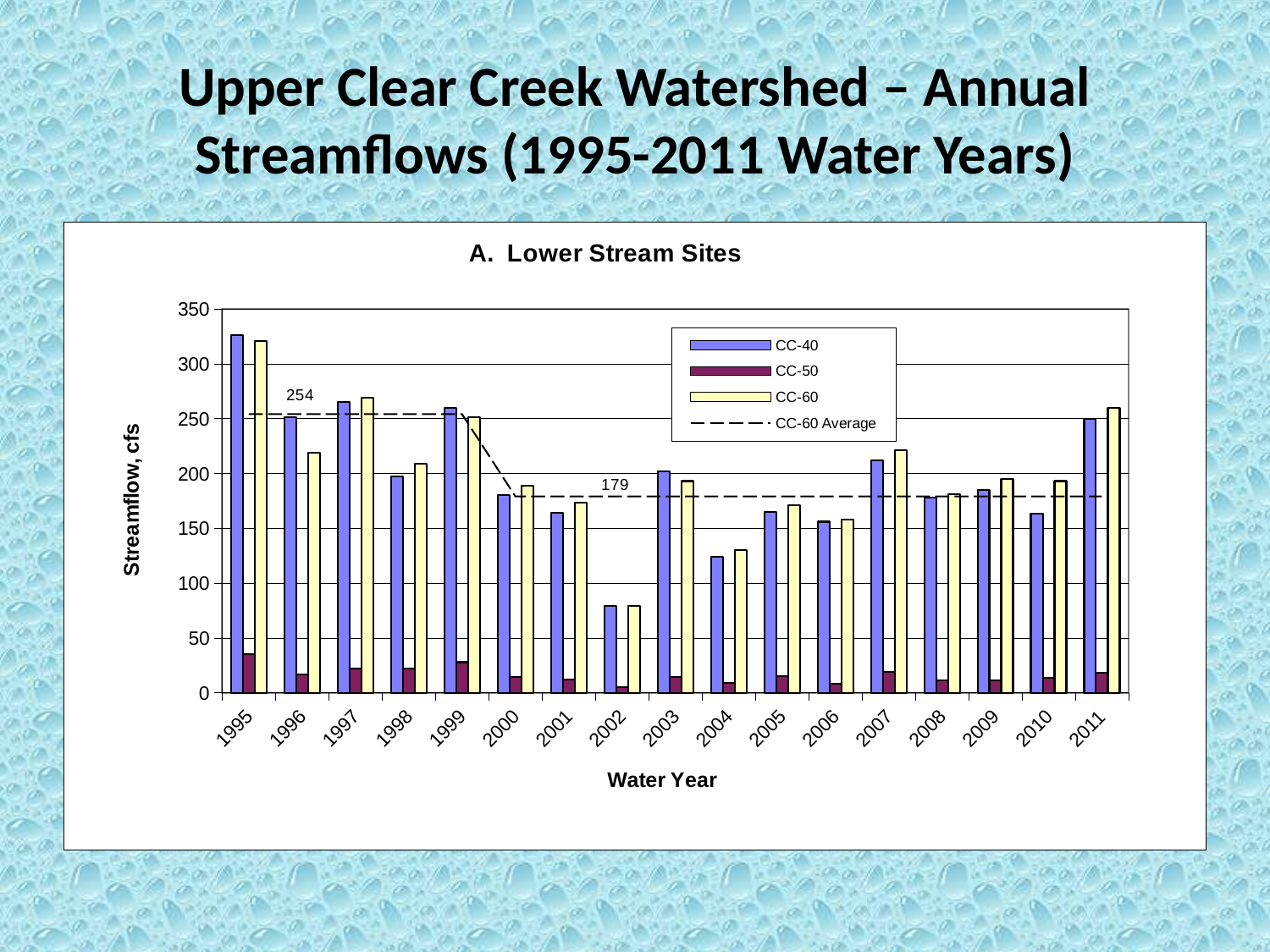
What is the difference between the two labelled CC-60 Average values, 254 and 179? 75 What is the CC-60 Average value labelled for the 2000–2011 period? 179 What is the CC-60 Average value labelled for the 1995–1999 period? 254 In 1996, which is larger, the CC-40 value or the CC-60 value? CC-40 How many water years are shown on the x axis of the chart? 17 Is the CC-60 value for 2002 greater or less than 100? less In which water year is the CC-40 streamflow lowest? 2002 Is the CC-40 value for 1995 greater or less than 300? greater What kind of chart is shown on the slide? Bar chart How many entries does the chart's legend list? 4 In which water year is the CC-40 streamflow highest? 1995 What is the label on the y axis of the chart? Streamflow, cfs